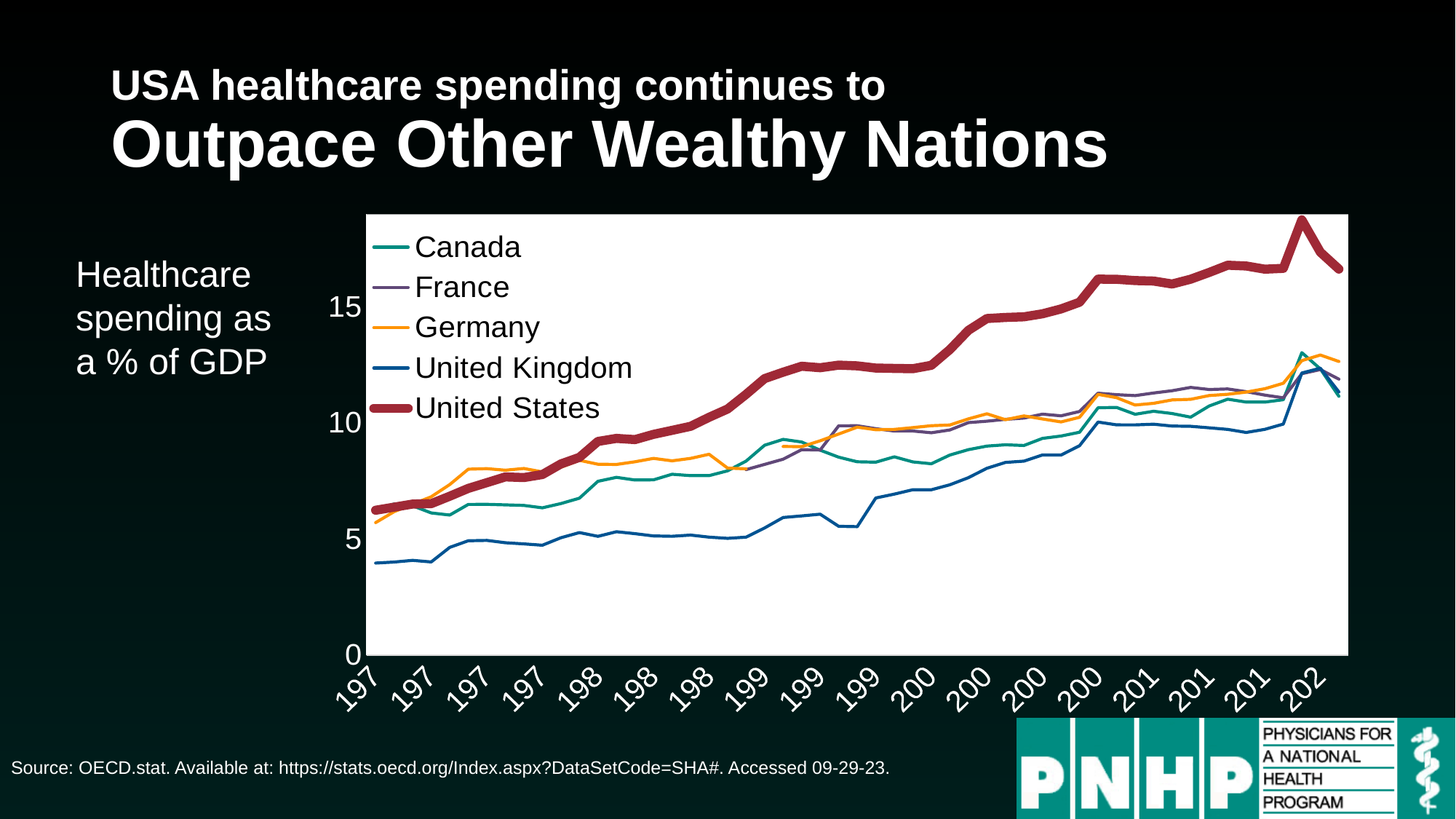
Is the value for the United Kingdom at the start of the chart greater or less than 5? less How many series does the chart's legend list? 5 Does the United Kingdom line rise or fall overall from left to right? rises Is the peak value of the United States line greater or less than 15? greater What quantity does the chart plot, according to the text to its left? Healthcare spending as a % of GDP Which series has the lowest value at the start of the chart? United Kingdom What kind of chart is shown on the slide? line chart Is the value for Germany at the end of the chart greater or less than 10? greater Which countries are listed in the chart's legend? Canada, France, Germany, United Kingdom, United States Which series has the highest values across the chart? United States Does the United States line rise or fall overall from left to right? rises At the end of the chart, which is larger: the United States value or the Canada value? United States